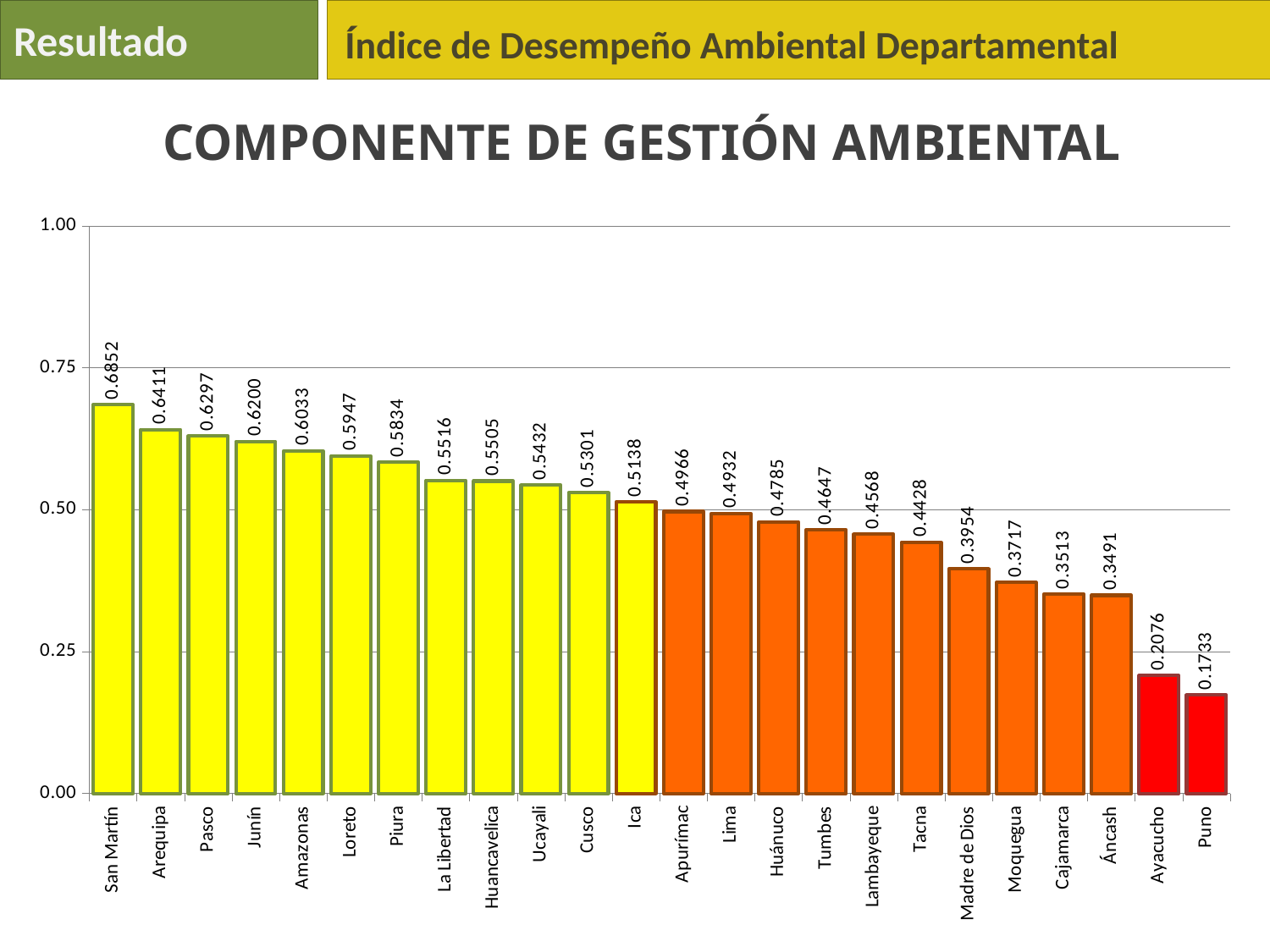
Which department has the highest value? San Martín Which department has the lowest value? Puno Do the values rise or fall from left to right along the x axis? fall Which has a larger value, Lima or Tacna? Lima What kind of chart is shown on the slide? bar chart What is the value for Arequipa? 0.6411 What is the difference between the values for San Martín and Puno? 0.5119 What is the value for Madre de Dios? 0.3954 How many departments are shown on the chart? 24 Is the value for Cusco greater or less than 0.50? greater What is the value for Lambayeque? 0.4568 What is the difference between the values for Ayacucho and Puno? 0.0343